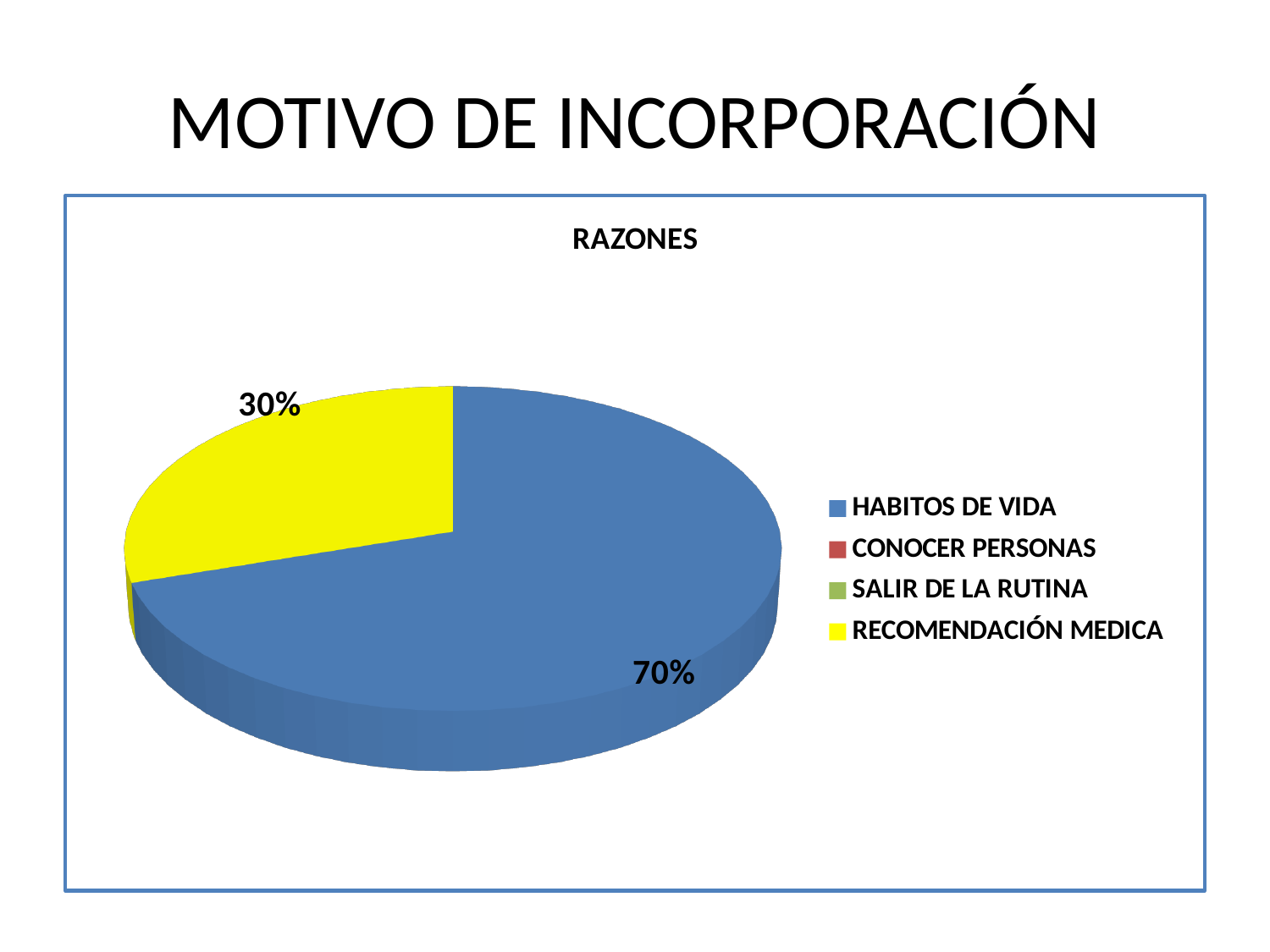
How many slices are visible in the pie? 2 Which category has the largest slice of the pie? HABITOS DE VIDA What colour represents HABITOS DE VIDA in the chart? Blue What is the difference in percentage points between HABITOS DE VIDA and RECOMENDACIÓN MEDICA? 40% How many categories does the legend list? 4 What type of chart is shown on the slide? Pie chart What share of the pie does RECOMENDACIÓN MEDICA represent? 30% What share of the pie does HABITOS DE VIDA represent? 70% What is the title of the chart? RAZONES Is the share for HABITOS DE VIDA greater or less than 50%? greater Which is larger, HABITOS DE VIDA or RECOMENDACIÓN MEDICA? HABITOS DE VIDA